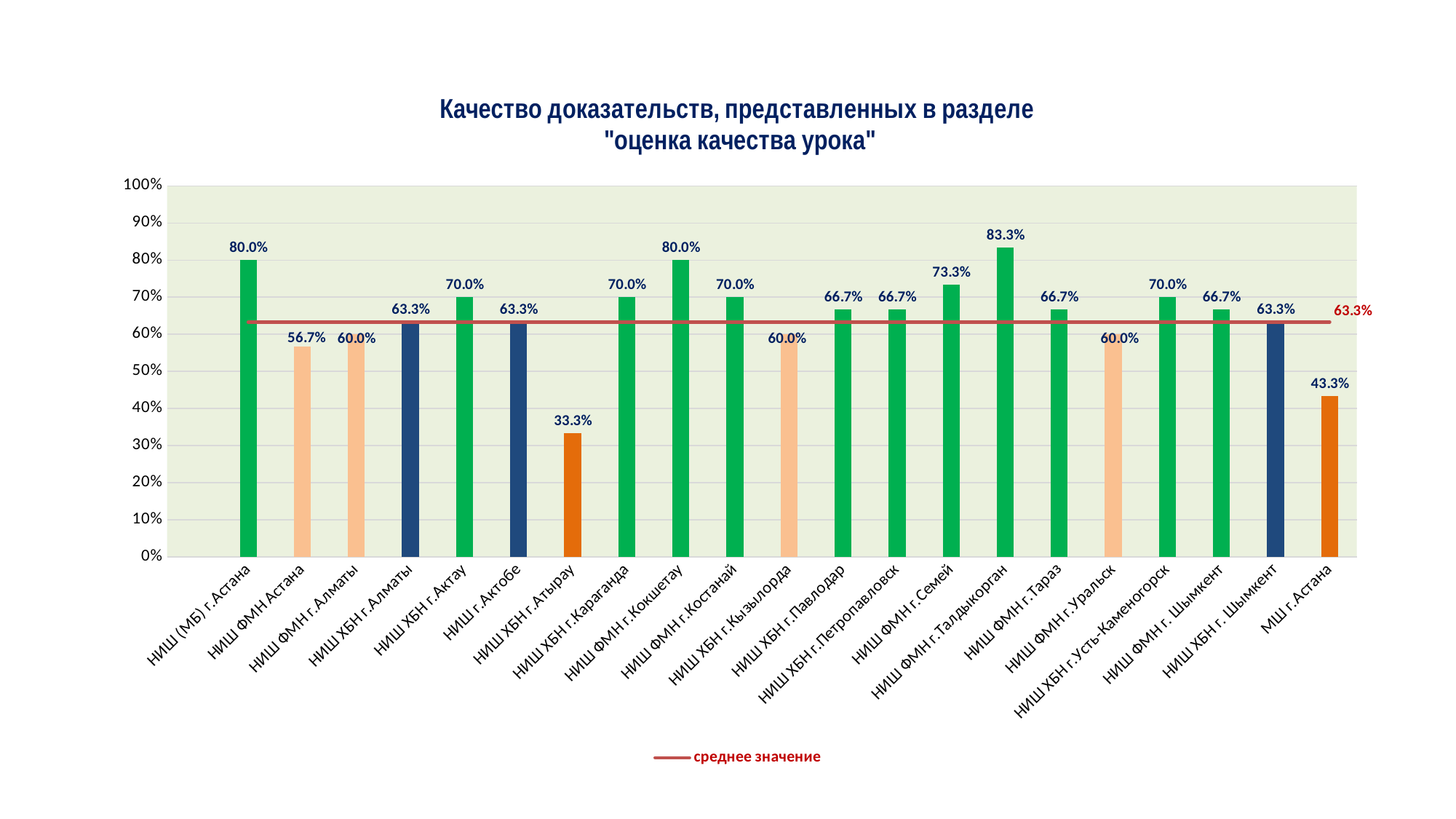
Which category has the highest value? НИШ ФМН г.Талдыкорган Which is larger, the value for НИШ ФМН г.Семей or the value for НИШ ФМН г.Тараз? НИШ ФМН г.Семей What value does the red horizontal line (среднее значение) mark? 63.3% Which category has the lowest value? НИШ ХБН г.Атырау What value is shown for НИШ ФМН Астана? 56.7% What kind of chart is this? Bar chart What value is shown for НИШ ХБН г.Атырау? 33.3% How many categories are shown on the x axis? 21 What is the label of the line shown in the legend? среднее значение What is the difference between the values for НИШ ФМН г.Талдыкорган and НИШ ХБН г.Атырау? 50.0% What value is shown for НИШ ФМН г.Талдыкорган? 83.3% What value is shown for МШ г.Астана? 43.3%